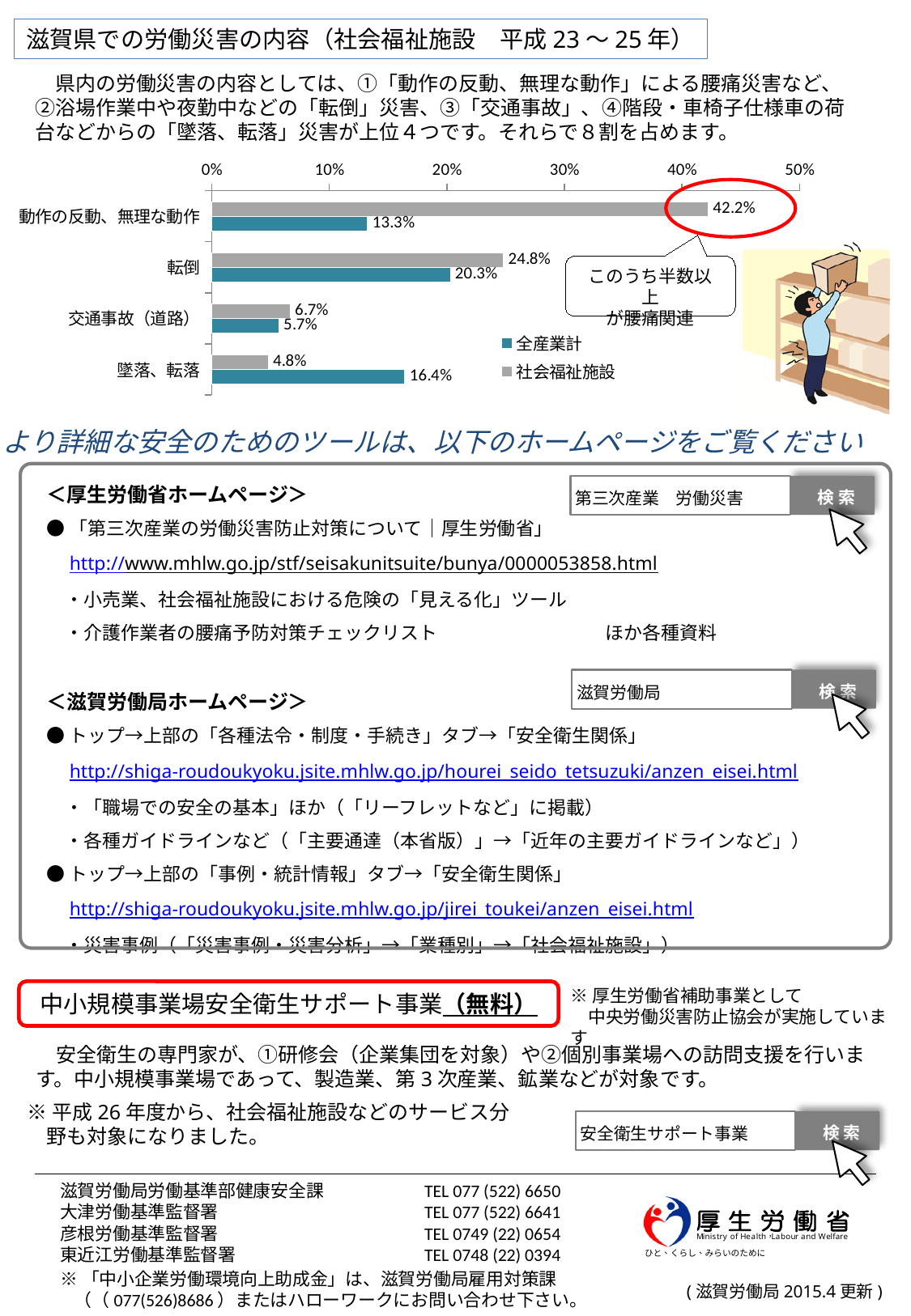
Which category has the highest value for 社会福祉施設? 動作の反動、無理な動作 How many series does the legend list? 2 What is the value for 社会福祉施設 in the 動作の反動、無理な動作 category? 42.2% What kind of chart is shown on the slide? bar chart What is the value for 全産業計 in the 転倒 category? 20.3% What is the difference between the 社会福祉施設 and 全産業計 values in the 動作の反動、無理な動作 category? 28.9% Is the 社会福祉施設 value for 動作の反動、無理な動作 greater or less than 40%? greater What is the value for 全産業計 in the 墜落、転落 category? 16.4% How many categories are shown on the chart? 4 Which category has the lowest value for 全産業計? 交通事故（道路） What is the value for 社会福祉施設 in the 交通事故（道路） category? 6.7% In the 墜落、転落 category, which series has the larger value, 全産業計 or 社会福祉施設? 全産業計